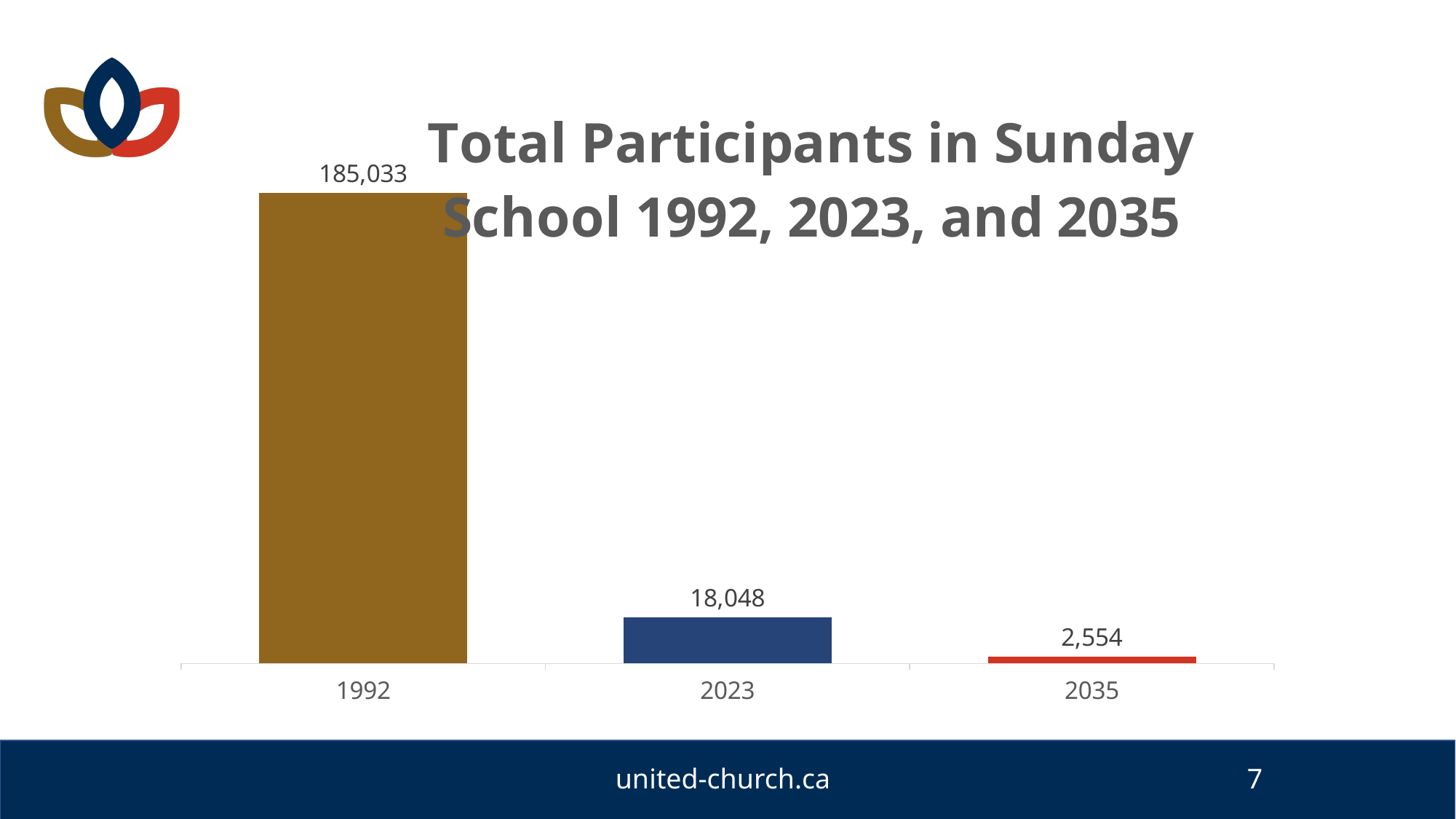
Which is larger, the value for 2023 or the value for 2035? 2023 How many years are shown on the chart? 3 Which year has the lowest number of participants? 2035 Which year has the highest number of participants? 1992 What is the value for 1992? 185,033 Do the values rise or fall from 1992 to 2035? fall What is the difference between the values for 1992 and 2023? 166,985 What is the title of the chart? Total Participants in Sunday School 1992, 2023, and 2035 What is the value for 2023? 18,048 What is the value for 2035? 2,554 What kind of chart is this? bar chart What is the difference between the values for 2023 and 2035? 15,494